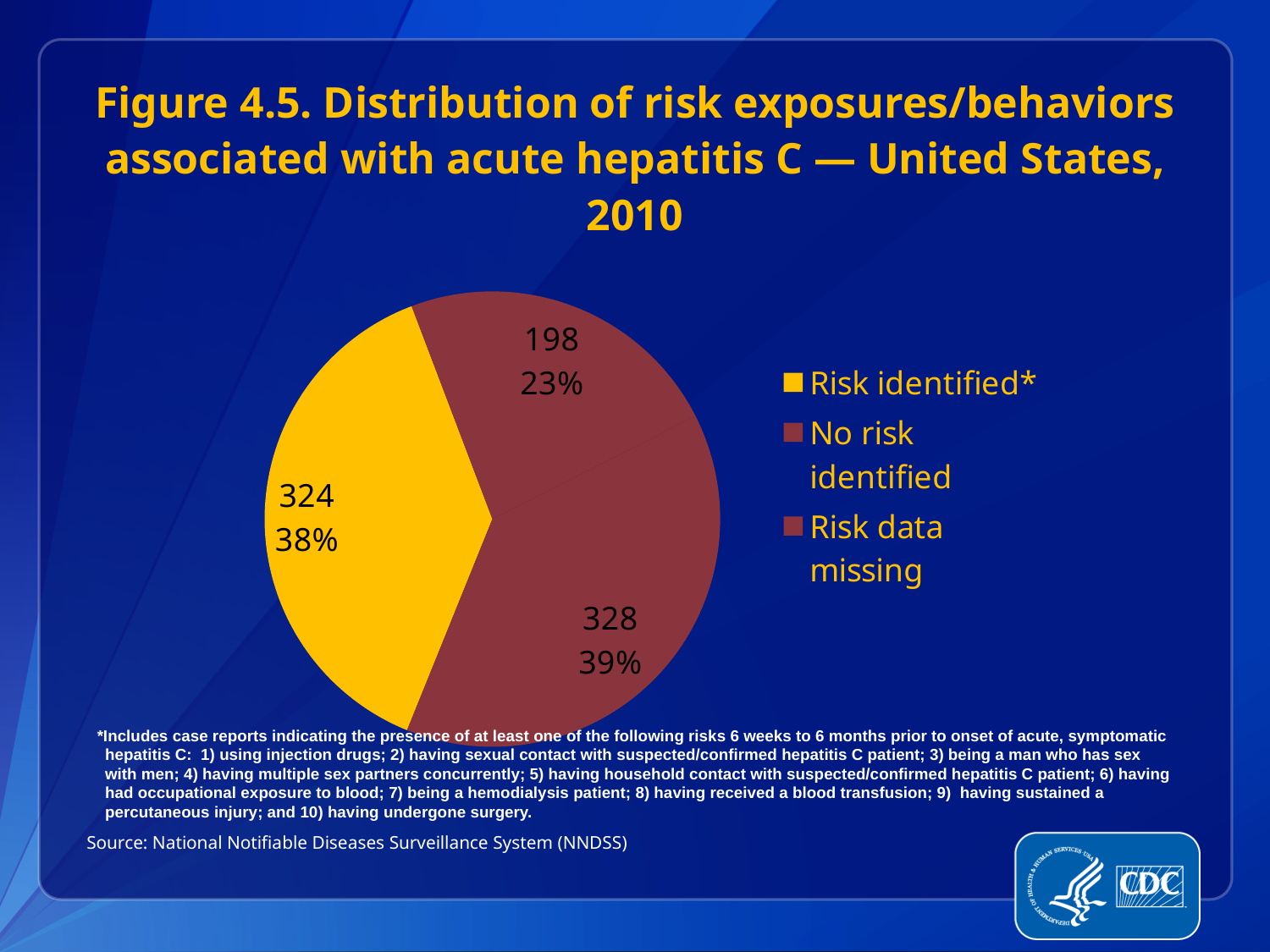
What percentage is shown for the smallest slice of the pie? 23% What year does the chart title say the data is for? 2010 How many slices does the pie chart have? 3 What colour is the 'Risk identified*' slice? yellow What is the number of cases for the 'Risk identified*' slice? 324 What is the difference between the largest slice value (328) and the 'Risk identified*' value? 4 What type of chart is shown on the slide? pie chart What is the difference between the 'Risk identified*' value and the smallest slice value (198)? 126 What is the largest value shown on the pie chart? 328 What percentage of the pie does the 'Risk identified*' slice represent? 38% What is the smallest value shown on the pie chart? 198 How many entries does the legend list? 3